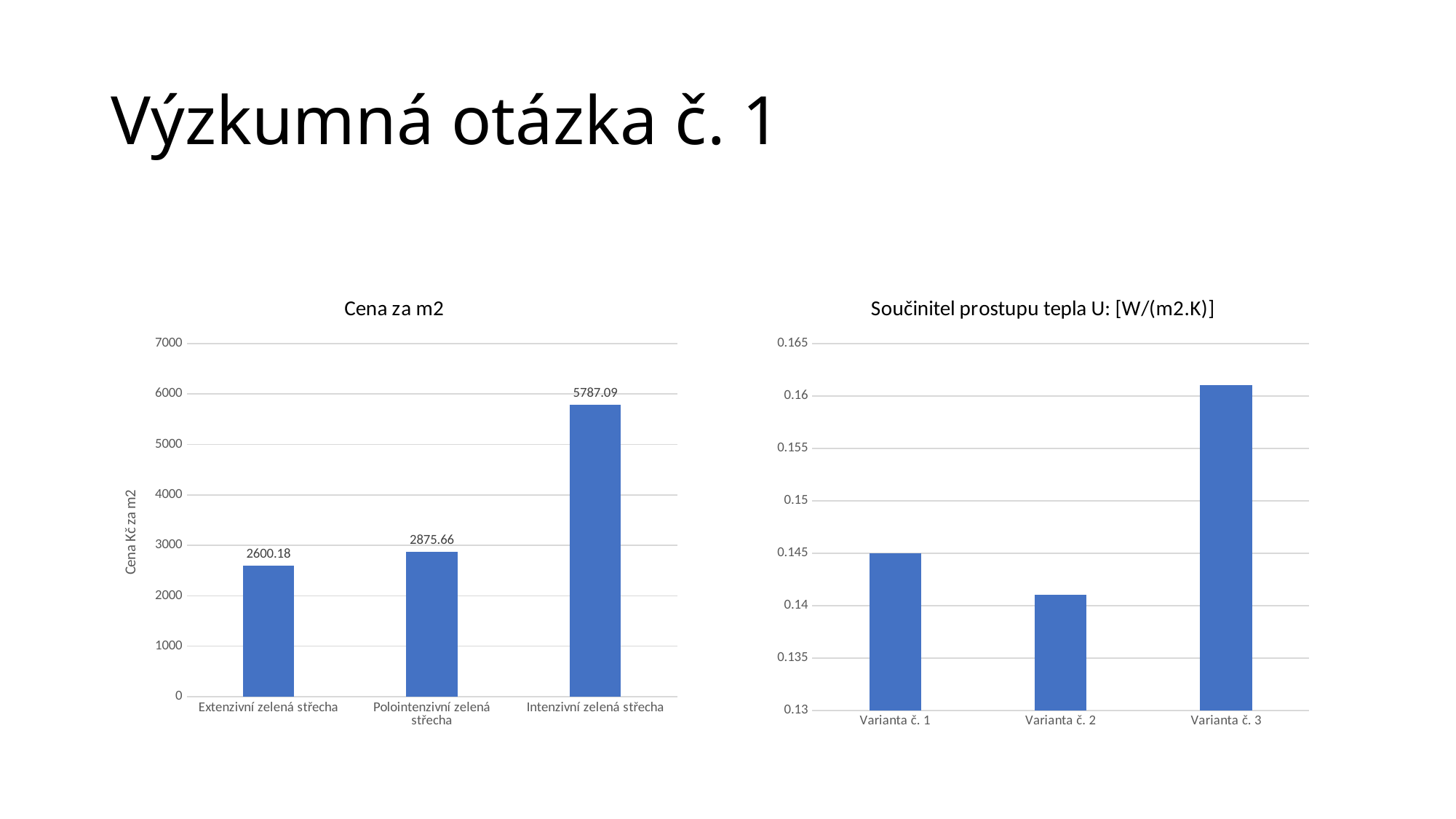
In the 'Cena za m2' chart, which category has the lowest value? Extenzivní zelená střecha In the 'Cena za m2' chart, what is the value for Polointenzivní zelená střecha? 2875.66 In the 'Součinitel prostupu tepla U: [W/(m2.K)]' chart, is the value for Varianta č. 3 greater or less than 0.155? greater In the 'Součinitel prostupu tepla U: [W/(m2.K)]' chart, which variant has the highest value? Varianta č. 3 In the 'Součinitel prostupu tepla U: [W/(m2.K)]' chart, is the value for Varianta č. 2 greater or less than 0.145? less What type of chart is the 'Cena za m2' chart on the left? Bar chart In the 'Cena za m2' chart, which category has the highest value? Intenzivní zelená střecha In the 'Součinitel prostupu tepla U: [W/(m2.K)]' chart, which variant has the lowest value? Varianta č. 2 In the 'Cena za m2' chart, what is the difference between Intenzivní zelená střecha and Extenzivní zelená střecha? 3186.91 In the 'Cena za m2' chart, what is the value for Extenzivní zelená střecha? 2600.18 In the 'Cena za m2' chart, what is the value for Intenzivní zelená střecha? 5787.09 In the 'Cena za m2' chart, how many categories are shown? 3